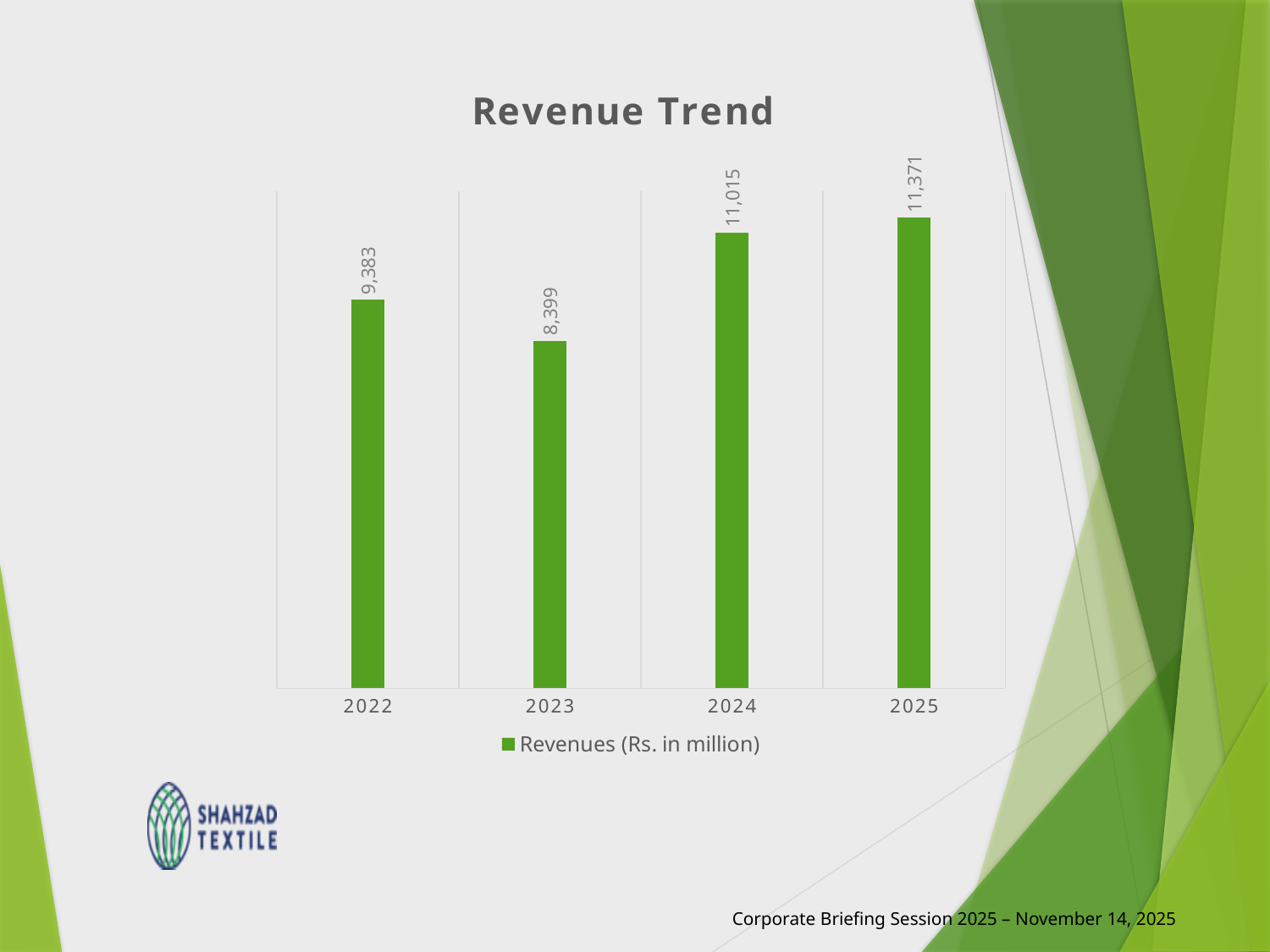
Which year has the highest revenue? 2025 What is the revenue value for 2025? 11,371 Which year has the larger revenue, 2022 or 2024? 2024 What is the title of the chart? Revenue Trend What is the revenue value for 2023? 8,399 Which year has the lowest revenue? 2023 What is the revenue value for 2022? 9,383 What is the difference between the revenue in 2022 and the revenue in 2023? 984 What is the difference between the revenue in 2025 and the revenue in 2024? 356 What is the revenue value for 2024? 11,015 How many years are shown on the chart? 4 What kind of chart is shown on the slide? Bar chart